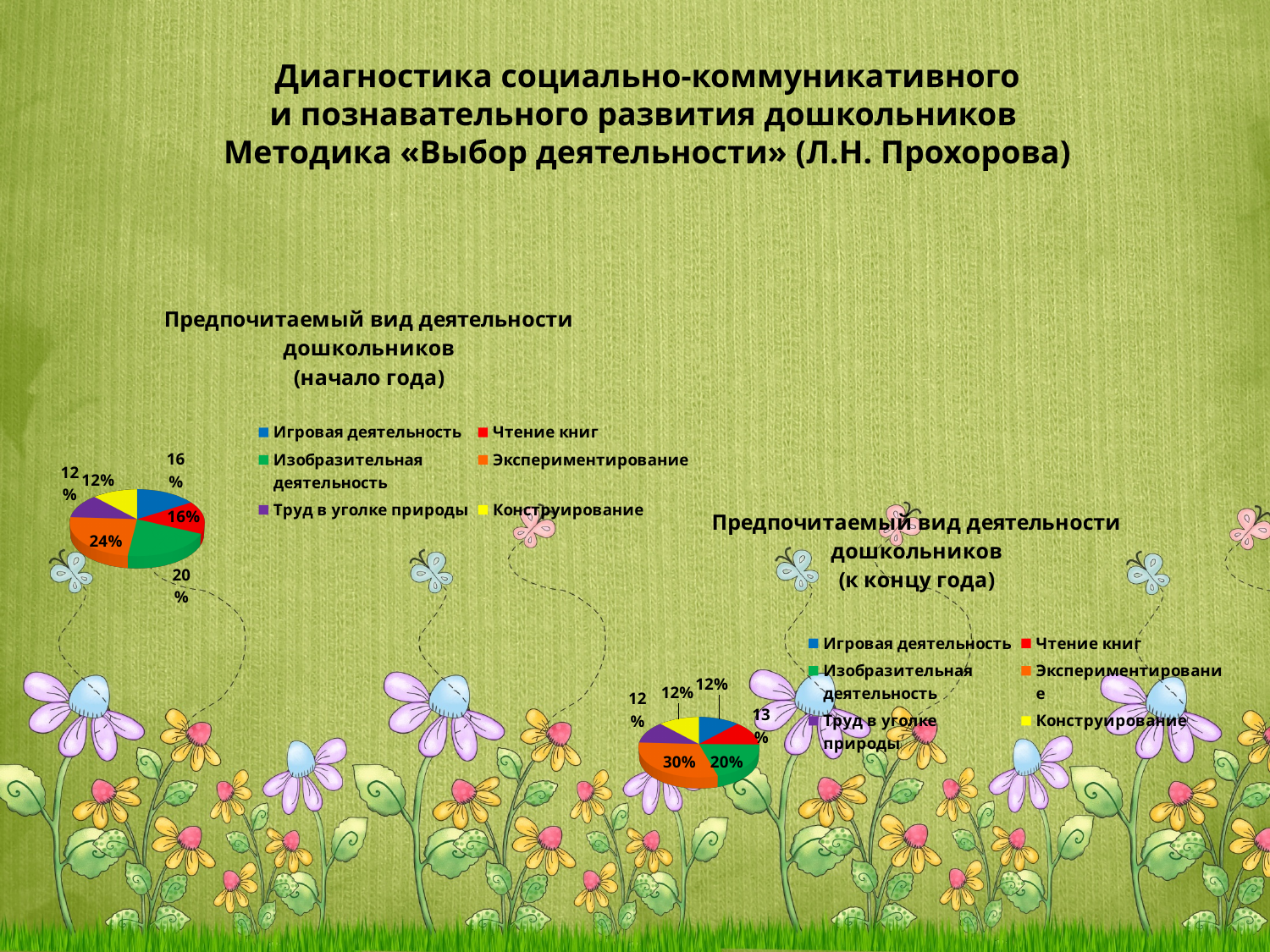
In the 'к концу года' chart, what share is shown for Экспериментирование? 30% What kind of chart is the 'Предпочитаемый вид деятельности дошкольников (начало года)' chart? pie chart In the 'начало года' chart, what share is shown for Изобразительная деятельность? 20% By how many percentage points did the share for Экспериментирование change from the 'начало года' chart to the 'к концу года' chart? 6 percentage points In the 'к концу года' chart, which is larger: Экспериментирование or Изобразительная деятельность? Экспериментирование In the 'к концу года' chart, what share is shown for Изобразительная деятельность? 20% In the 'начало года' chart, what share is shown for Игровая деятельность? 16% In the 'к концу года' chart, which activity has the largest slice? Экспериментирование In the 'начало года' chart, what share is shown for Экспериментирование? 24% In the 'начало года' chart, which activity has the largest slice? Экспериментирование How many categories does the legend of the 'начало года' chart list? 6 In the 'начало года' chart, what is the difference between the shares for Экспериментирование and Изобразительная деятельность? 4 percentage points